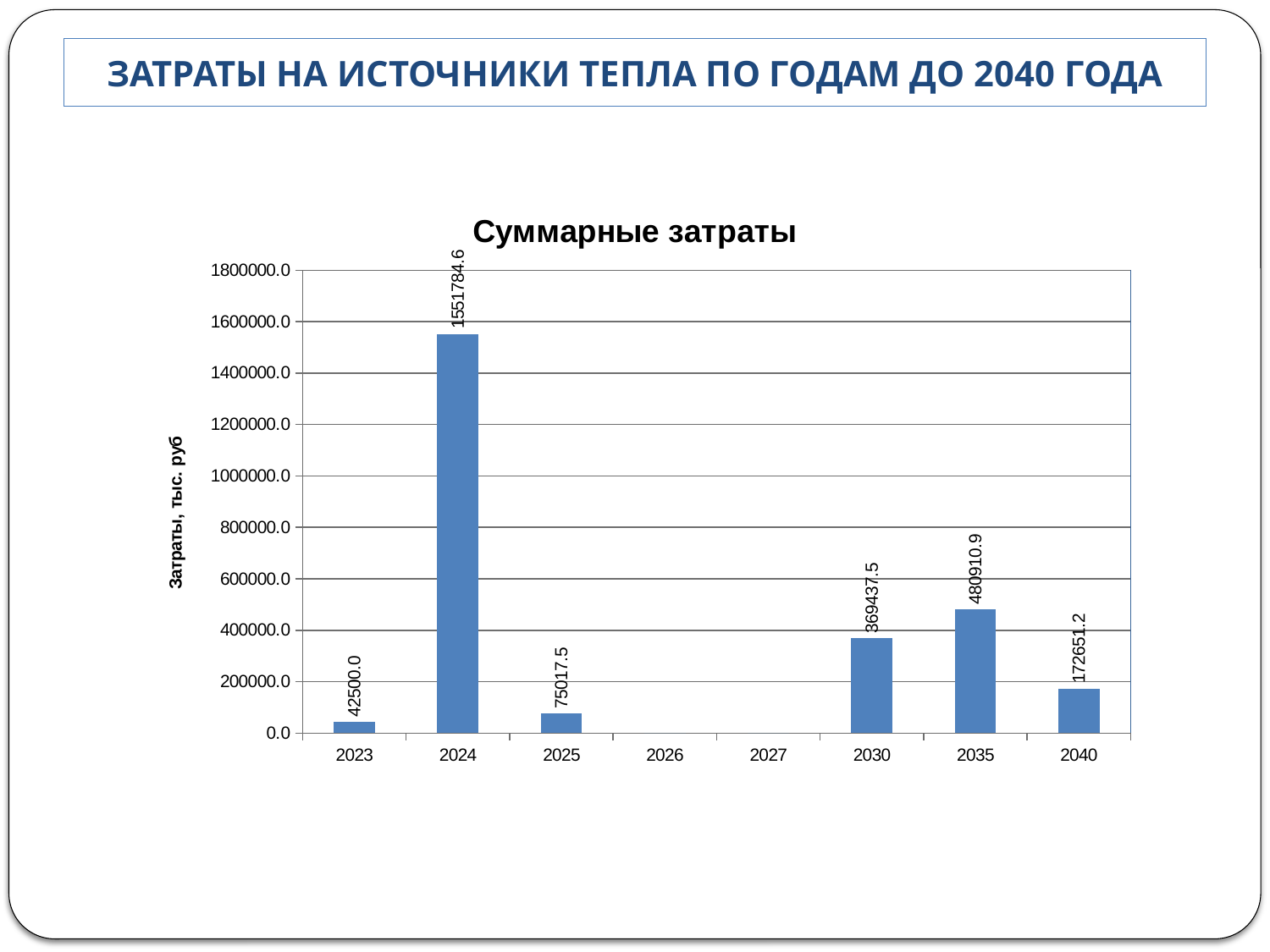
What is the difference between the values for 2040 and 2025? 97633.7 Which is larger, the value for 2030 or the value for 2040? 2030 What is the difference between the values for 2035 and 2030? 111473.4 What is the value for 2040 in the chart? 172651.2 Is the value for 2035 greater or less than 400000.0? greater What is the title of the chart? Суммарные затраты What is the value for 2023 in the chart? 42500.0 What is the value for 2024 in the chart? 1551784.6 How many year labels are shown on the x axis of the chart? 8 What is the value for 2035 in the chart? 480910.9 Which year has the highest value in the chart? 2024 What kind of chart is shown on the slide? bar chart